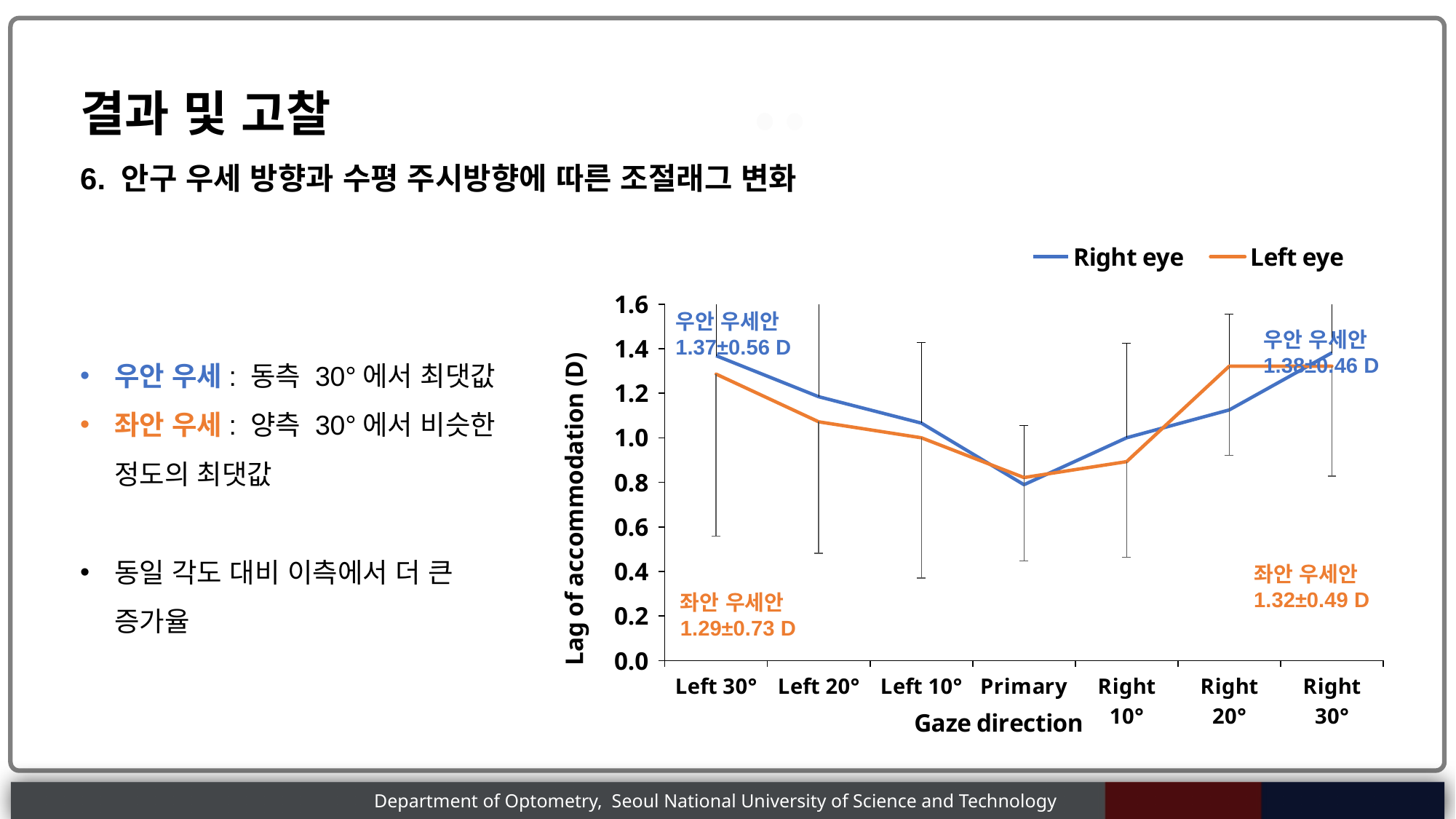
What is the title of the y axis? Lag of accommodation (D) What is the labelled value for the Right eye series at Left 30°? 1.37±0.56 D What is the labelled value for the Left eye series at Left 30°? 1.29±0.73 D Is the Right eye value at Primary greater or less than 1.0? less How many series does the chart legend list? 2 What is the labelled value for the Right eye series at Right 30°? 1.38±0.46 D What is the labelled value for the Left eye series at Right 30°? 1.32±0.49 D At which gaze direction is the Right eye lag of accommodation lowest? Primary Does the Right eye series rise or fall from Primary to Right 30°? Rise At Right 20°, which series has the larger value, Right eye or Left eye? Left eye What kind of chart is shown on the slide? Line chart How many gaze direction categories are plotted on the x axis? 7